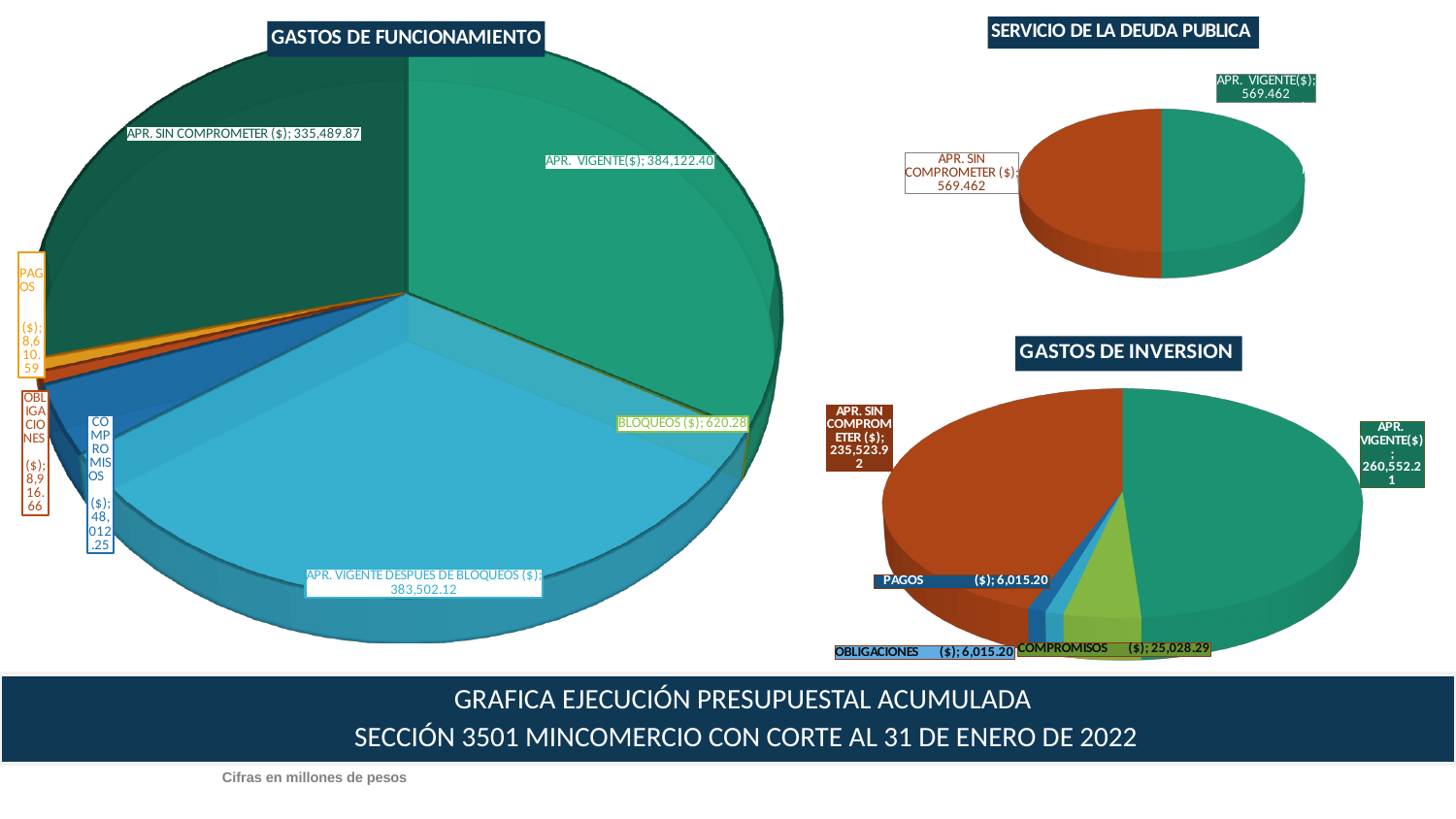
In the SERVICIO DE LA DEUDA PUBLICA chart, what is the value for APR. SIN COMPROMETER ($)? 569.462 In the GASTOS DE INVERSION chart, what is the difference between APR. VIGENTE($) and APR. SIN COMPROMETER ($)? 25,028.29 In the GASTOS DE INVERSION chart, what is the value for COMPROMISOS ($)? 25,028.29 What type of chart is GASTOS DE INVERSION? Pie chart In the GASTOS DE FUNCIONAMIENTO chart, what is the value for APR. VIGENTE DESPUES DE BLOQUEOS ($)? 383,502.12 In the GASTOS DE FUNCIONAMIENTO chart, what is the value for BLOQUEOS ($)? 620.28 In the GASTOS DE FUNCIONAMIENTO chart, what is the value for APR. VIGENTE($)? 384,122.40 In the GASTOS DE FUNCIONAMIENTO chart, which category has the smallest value? BLOQUEOS ($) In the GASTOS DE INVERSION chart, what is the value for APR. VIGENTE($)? 260,552.21 How many slices does the SERVICIO DE LA DEUDA PUBLICA chart have? 2 In the GASTOS DE FUNCIONAMIENTO chart, what is the difference between APR. VIGENTE($) and APR. VIGENTE DESPUES DE BLOQUEOS ($)? 620.28 In the GASTOS DE INVERSION chart, which category has the largest value? APR. VIGENTE($)